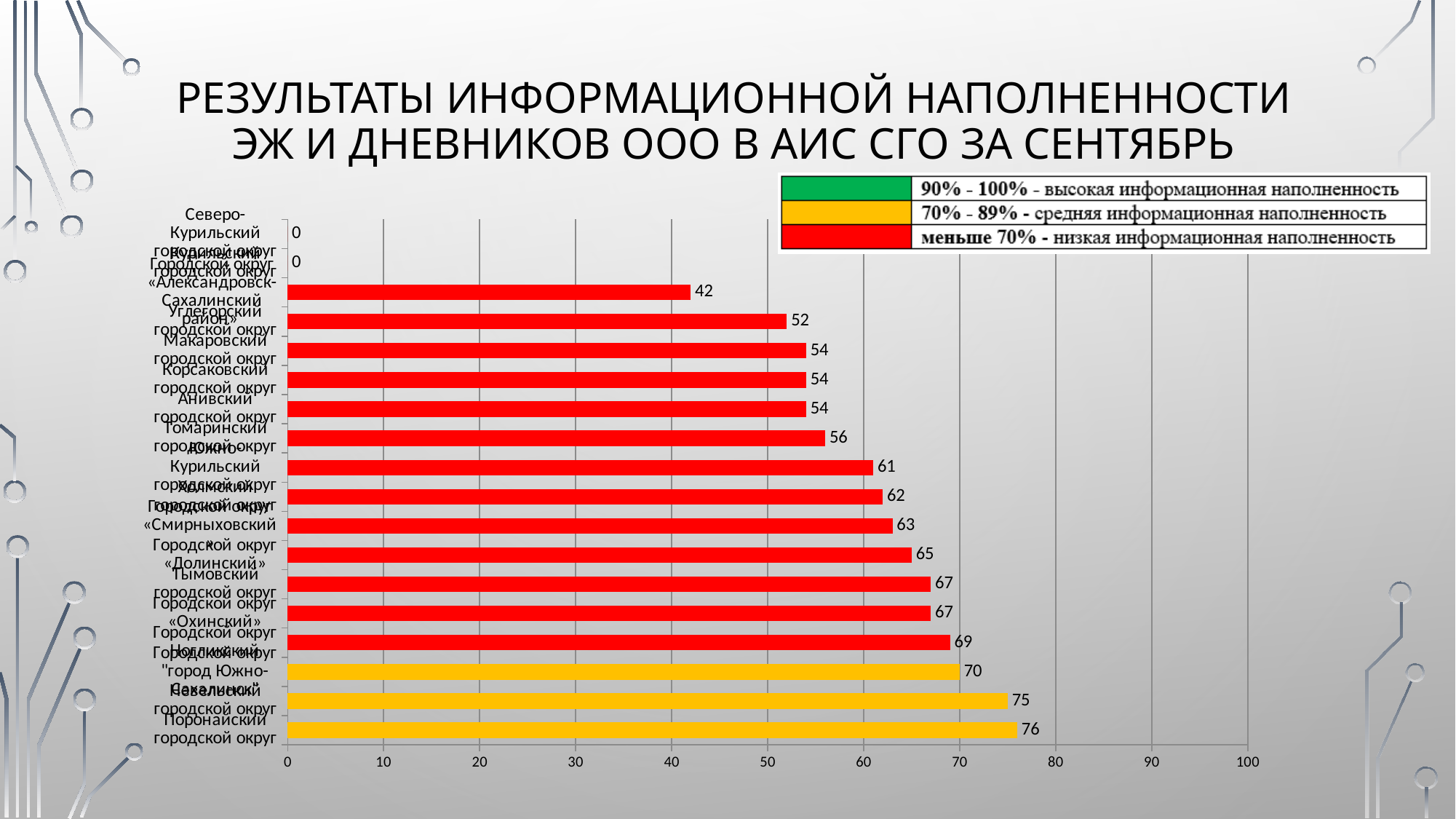
What type of chart is shown on the slide? bar chart Is the value for Поронайский городской округ greater or less than 70? greater What is the difference between the highest value (76) and the lowest non-zero value (42)? 34 What is the value for Поронайский городской округ? 76 What is the highest value shown in the chart? 76 According to the colour key, what range of values corresponds to the red colour? меньше 70% What is the value for Углегорский городской округ? 52 How many categories are plotted in the chart? 18 Which category has the highest value in the chart? Поронайский городской округ What is the value for Невельский городской округ? 75 How many bars are coloured yellow (orange) rather than red? 3 How many bars in the chart have the value 54? 3